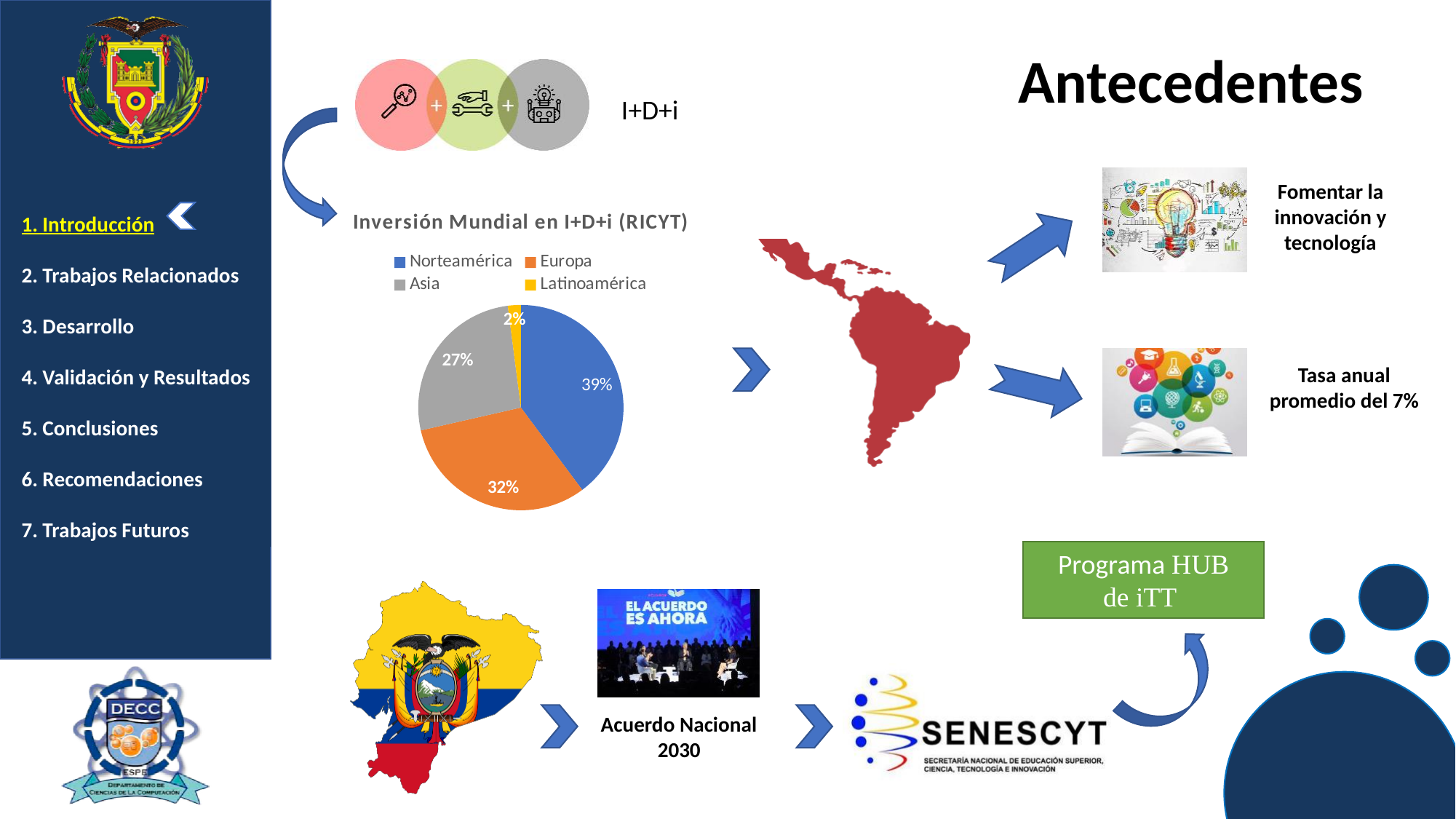
Which region has the largest slice of the pie? Norteamérica What share of the pie does Latinoamérica have? 2% What share of the pie does Asia have? 27% What share of the pie does Norteamérica have? 39% Which is larger, the share for Europa or the share for Asia? Europa What kind of chart is shown under the title 'Inversión Mundial en I+D+i (RICYT)'? pie chart Which region has the smallest slice of the pie? Latinoamérica What share of the pie does Europa have? 32% How many regions are shown in the pie chart? 4 What is the title of the pie chart? Inversión Mundial en I+D+i (RICYT) What is the difference in percentage points between Norteamérica and Europa? 7 Which colour represents Latinoamérica in the pie chart? yellow